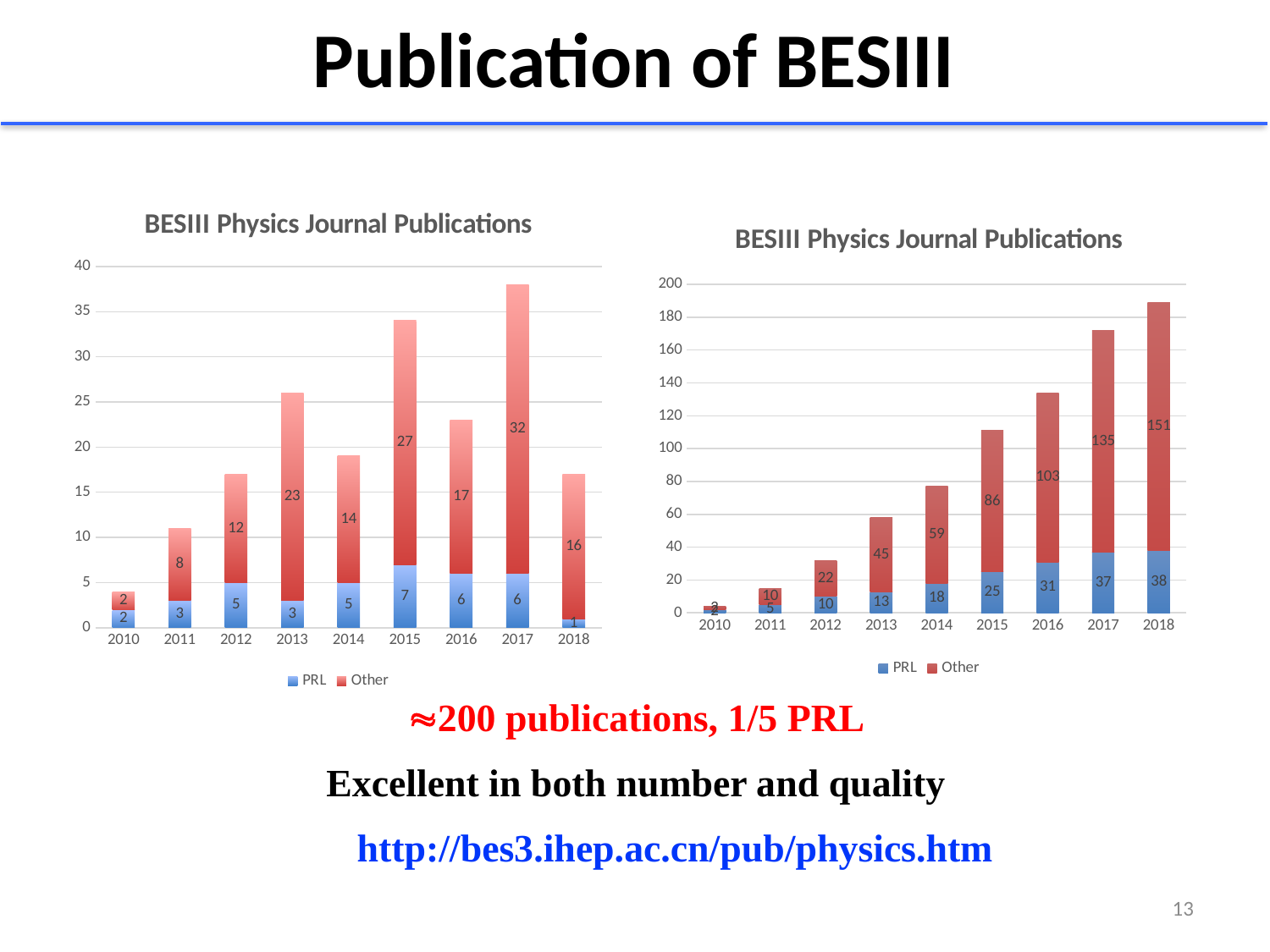
In the left chart, what is the total of the stacked bar for 2013? 26 How many years are shown on the x axis of the right chart? 9 In the left chart, what is the difference between the Other values for 2015 and 2016? 10 In the right chart, is the Other value for 2014 larger than the Other value for 2013? Yes, 2014 In the left chart, what is the PRL value for 2015? 7 In the left chart, which year has the highest Other value? 2017 In the left chart, what is the Other value for 2017? 32 In the right chart, what is the total of the stacked bar for 2017? 172 In the right chart, what is the PRL value for 2016? 31 In the left chart, which year has the lowest PRL value? 2018 How many series does the legend of the left chart list? 2 In the right chart, what is the Other value for 2018? 151